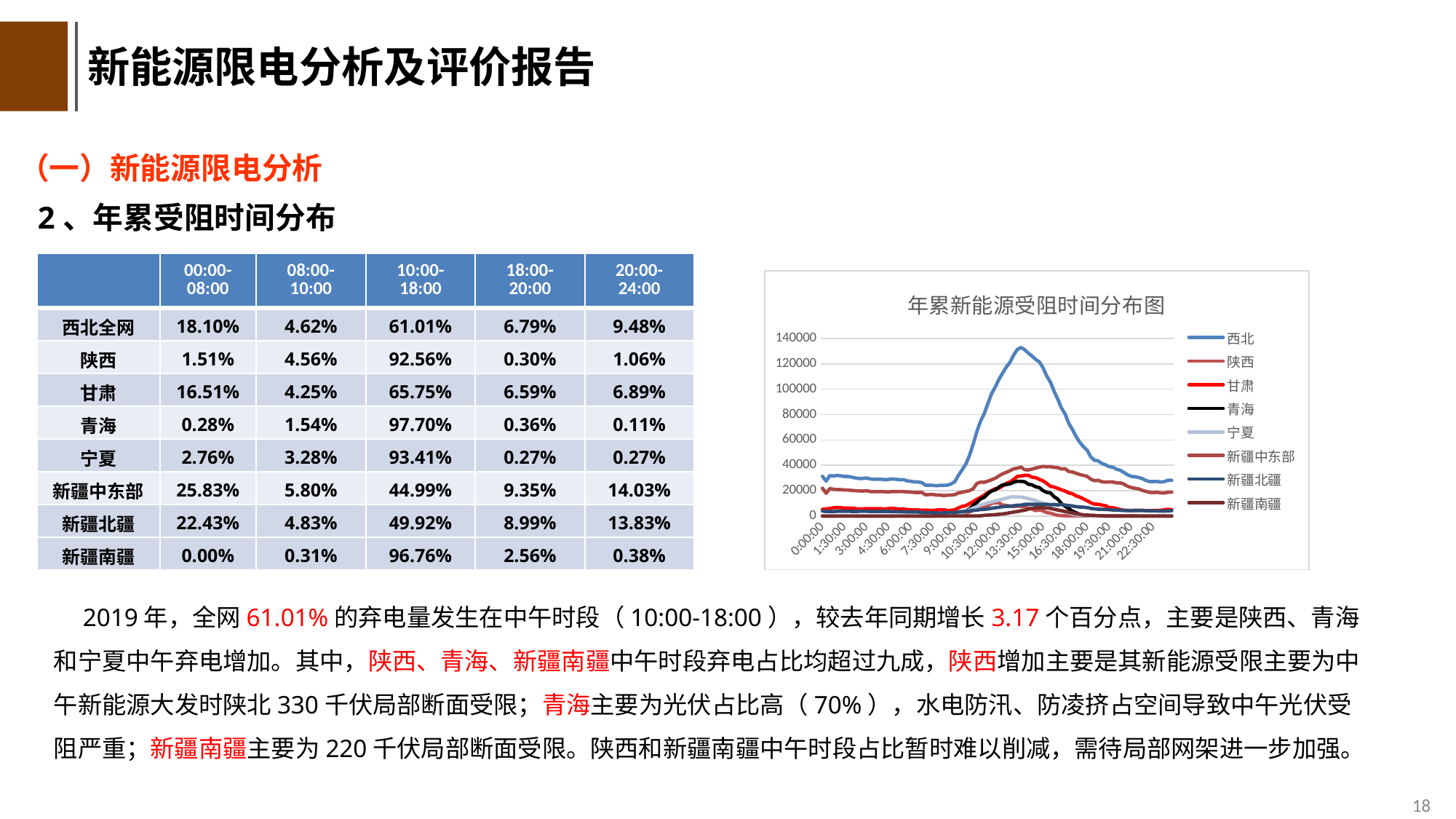
How many time labels are shown on the x axis of the 年累新能源受阻时间分布图? 16 What is the highest tick value shown on the y axis of the 年累新能源受阻时间分布图? 140000 What is the title of the chart on the slide? 年累新能源受阻时间分布图 Which series in the 年累新能源受阻时间分布图 reaches the highest value? 西北 In the 年累新能源受阻时间分布图, is the peak value of 甘肃 greater or less than 40000? less In the 年累新能源受阻时间分布图, does the 西北 line rise or fall between 9:00:00 and 13:30:00? rise How many series does the legend of the 年累新能源受阻时间分布图 list? 8 In the 年累新能源受阻时间分布图, at 13:30:00 which is higher, 西北 or 新疆中东部? 西北 In the 年累新能源受阻时间分布图, is the peak value of 西北 greater or less than 120000? greater What kind of chart is the 年累新能源受阻时间分布图? line chart In the 年累新能源受阻时间分布图, does the 西北 line rise or fall between 13:30:00 and 18:00:00? fall In the 年累新能源受阻时间分布图, is the peak value of 青海 greater or less than 20000? greater